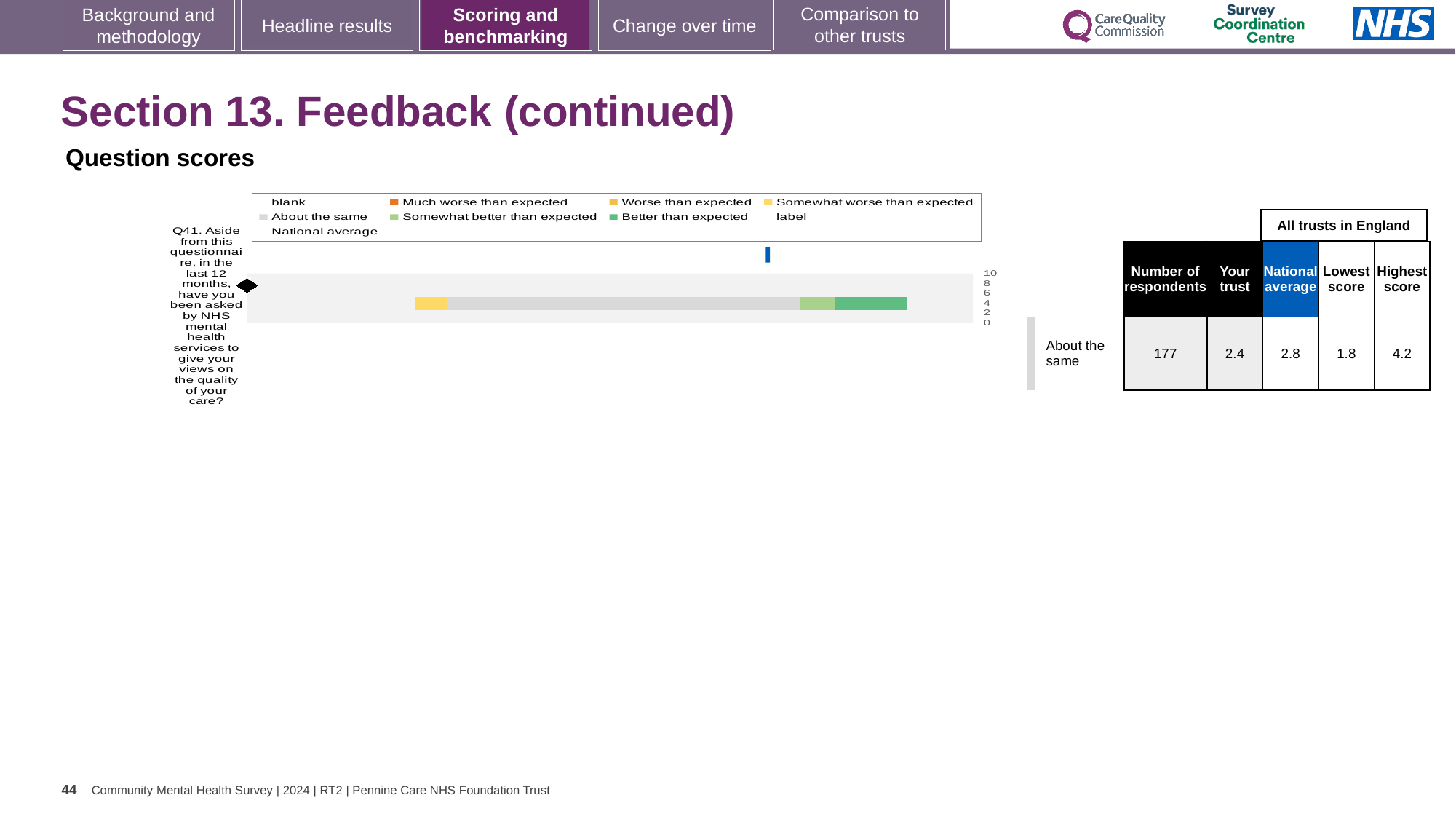
What is the lowest score among all trusts in England for Q41? 1.8 Which is larger for Q41, the 'Your trust' score or the national average? national average What is the 'Your trust' score shown for Q41? 2.4 What is the highest value shown on the chart's score axis? 10 What is the difference between the highest score and the lowest score for Q41? 2.4 How many respondents answered Q41? 177 What kind of chart is shown on the slide? bar chart What is the highest score among all trusts in England for Q41? 4.2 How many questions (bars) are plotted in the chart? 1 What is the benchmark category label shown next to the bar for Q41? About the same Which question number is plotted in the chart? Q41 What is the national average score shown for Q41? 2.8